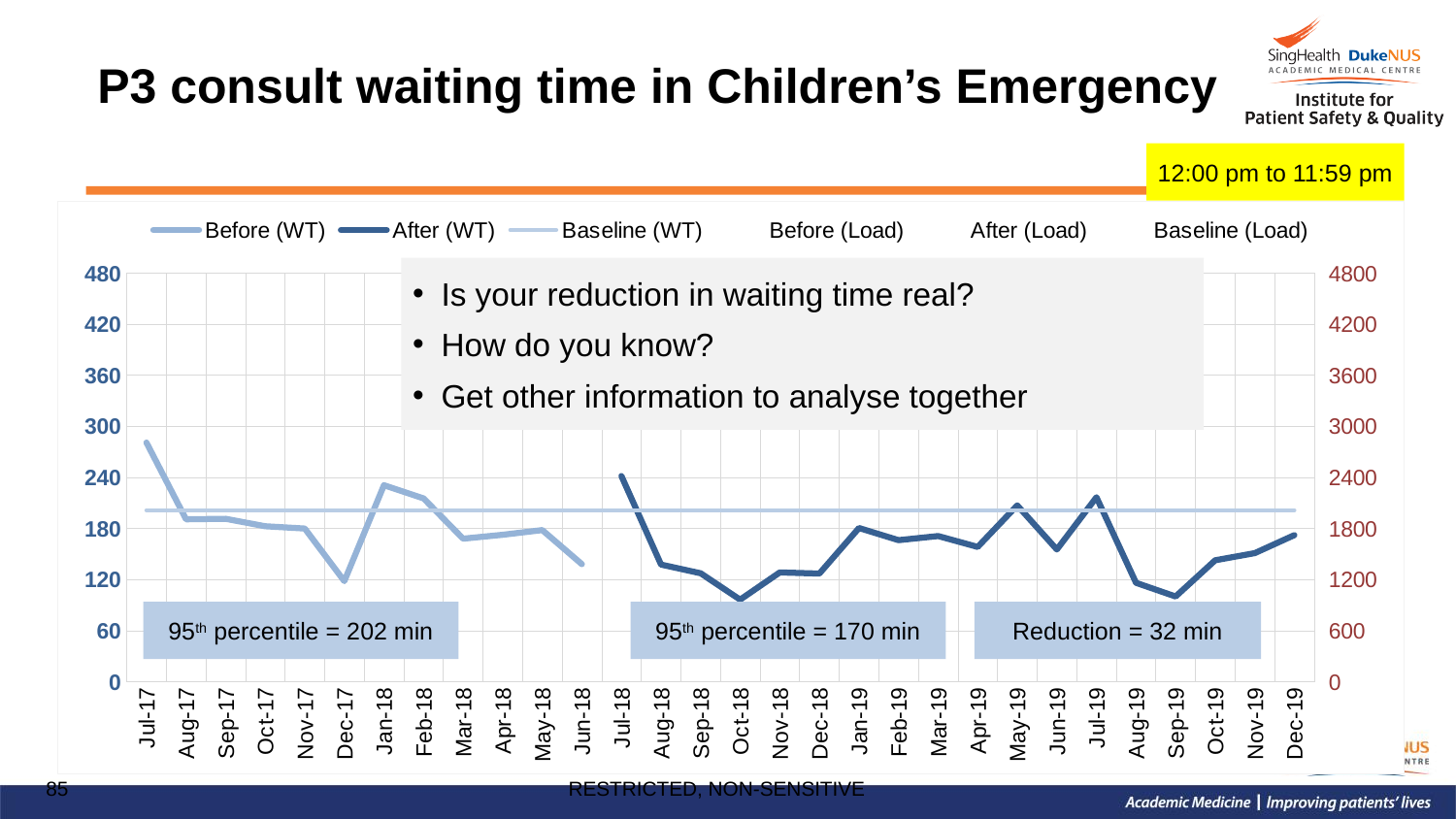
Does the Before (WT) series rise or fall from Jul-17 to Dec-17? fall Is the Before (WT) value for Jul-17 greater or less than 240? greater What is the title of the chart on the slide? P3 consult waiting time in Children's Emergency Is the Before (WT) value for Dec-17 greater or less than 180? less Is the After (WT) value for Oct-18 greater or less than 120? less Which is larger: the Before (WT) value for Jan-18 or the After (WT) value for Jan-19? Jan-18 Which month has the highest value for the Before (WT) series? Jul-17 What kind of chart is shown on the slide? line chart How many months are plotted along the x axis, from Jul-17 to Dec-19? 30 How many series does the chart legend list? 6 Which month has the lowest value for the Before (WT) series? Dec-17 Which month has the highest value for the After (WT) series? Jul-18